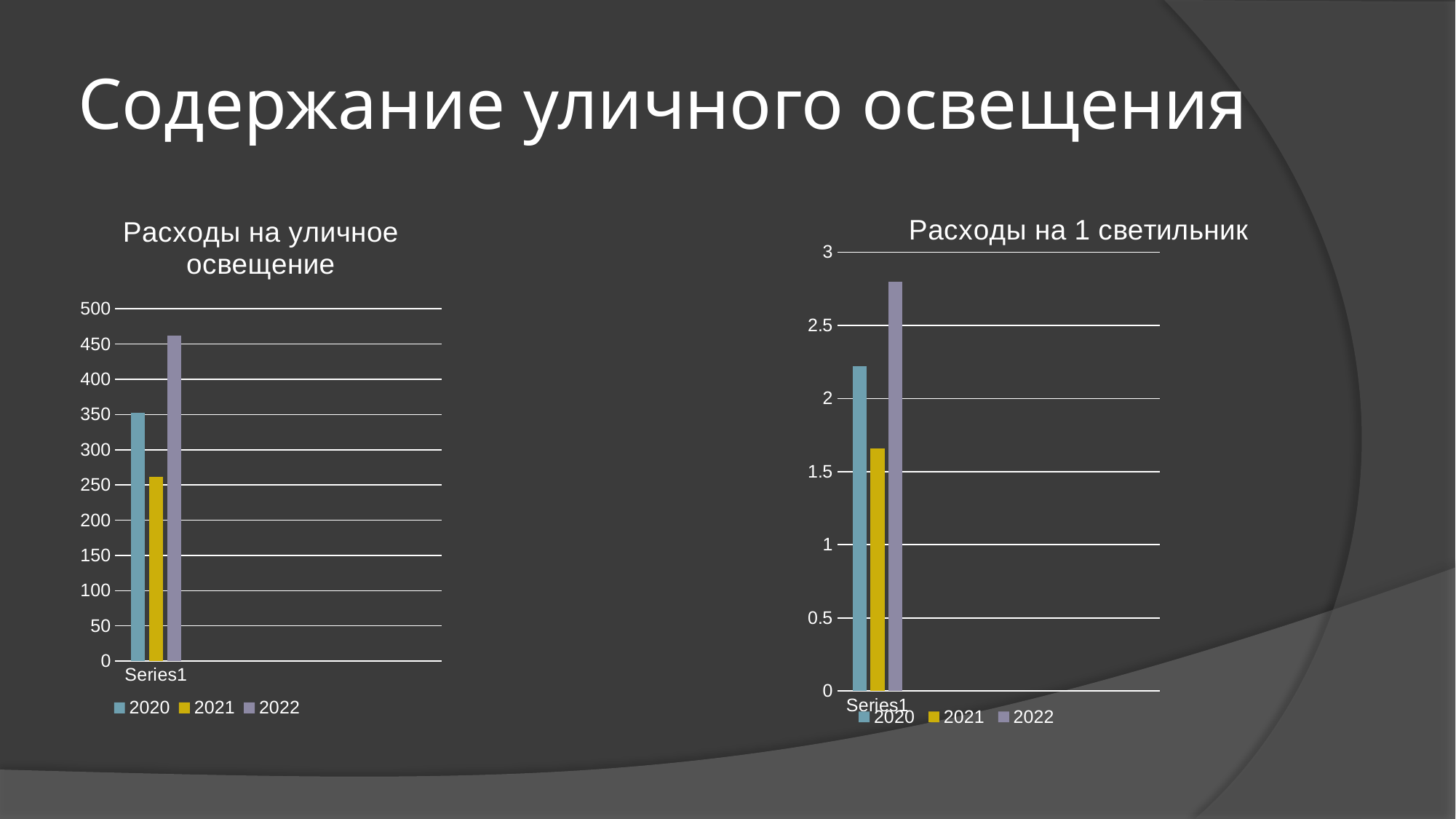
What kind of chart is the 'Расходы на уличное освещение' chart? bar chart In the 'Расходы на 1 светильник' chart, is the value for 2022 greater or less than 2.5? greater In the 'Расходы на уличное освещение' chart, which year has the highest value? 2022 How many series does the legend of the 'Расходы на уличное освещение' chart list? 3 In the 'Расходы на 1 светильник' chart, which year has the highest value? 2022 What is the title of the chart on the right side of the slide? Расходы на 1 светильник In the 'Расходы на уличное освещение' chart, is the value for 2020 greater or less than 300? greater In the 'Расходы на уличное освещение' chart, is the value for 2022 greater or less than 500? less In the 'Расходы на 1 светильник' chart, which year has the lowest value? 2021 In the 'Расходы на уличное освещение' chart, which year has the lowest value? 2021 In the 'Расходы на уличное освещение' chart, which is larger, the value for 2020 or the value for 2021? 2020